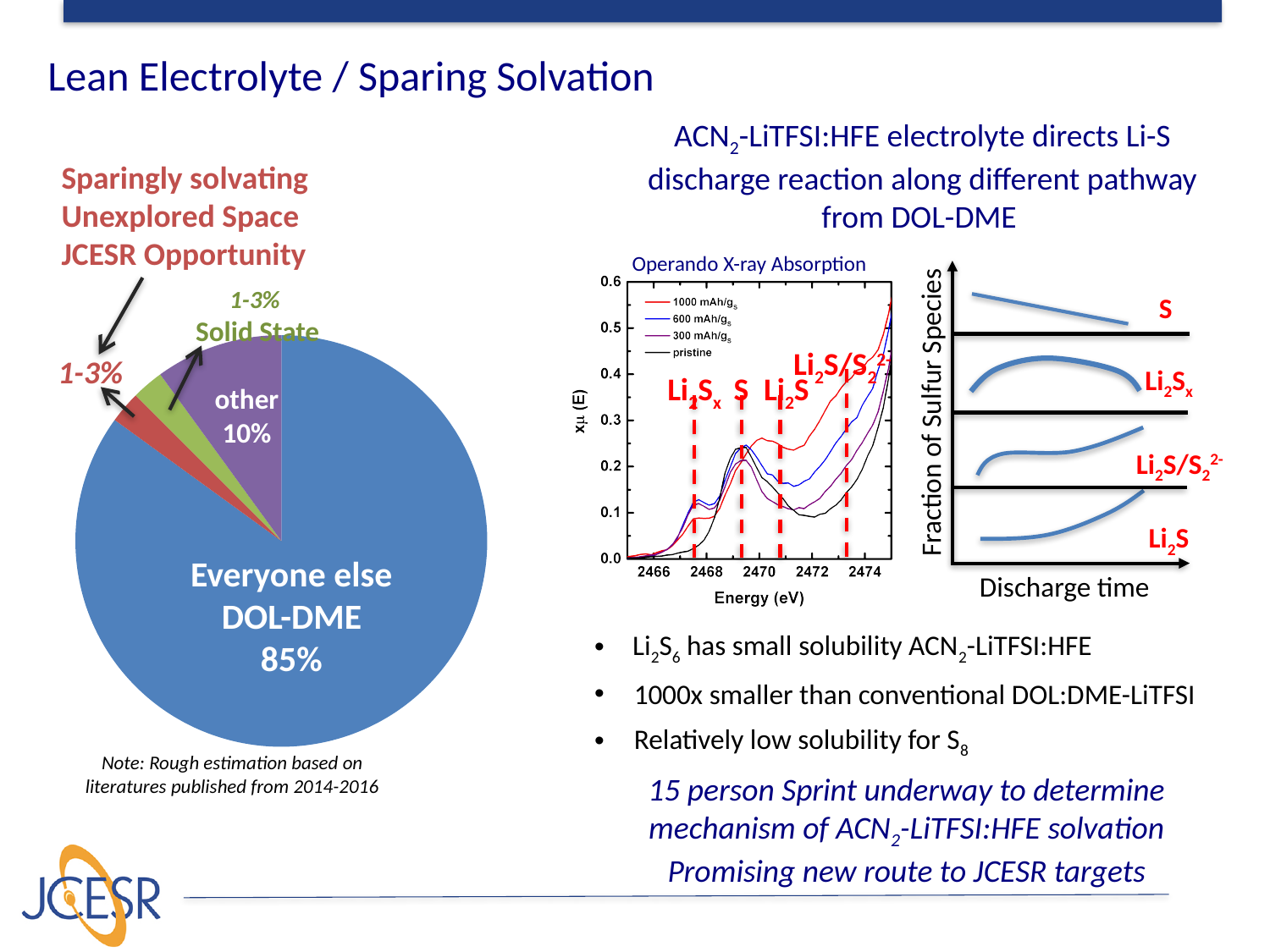
What kind of chart is the chart on the left of the slide? Pie chart In the pie chart on the left, what share is labelled for Solid State? 1-3% In the Fraction of Sulfur Species chart on the right, does the S curve rise or fall with discharge time? Fall In the pie chart on the left, what share is labelled for the 'other' slice? 10% In the pie chart on the left, what is the difference in percentage points between the Everyone else DOL-DME slice and the 'other' slice? 75 percentage points What is the x-axis label of the Operando X-ray Absorption chart? Energy (eV) In the pie chart on the left, what share is labelled for Everyone else DOL-DME? 85% In the pie chart on the left, which is larger, the 'other' slice or the Solid State slice? other In the pie chart on the left, which slice is the largest? Everyone else DOL-DME What kind of chart is the Operando X-ray Absorption chart? Line chart How many slices does the pie chart on the left have? 4 How many series does the legend of the Operando X-ray Absorption chart list? 4